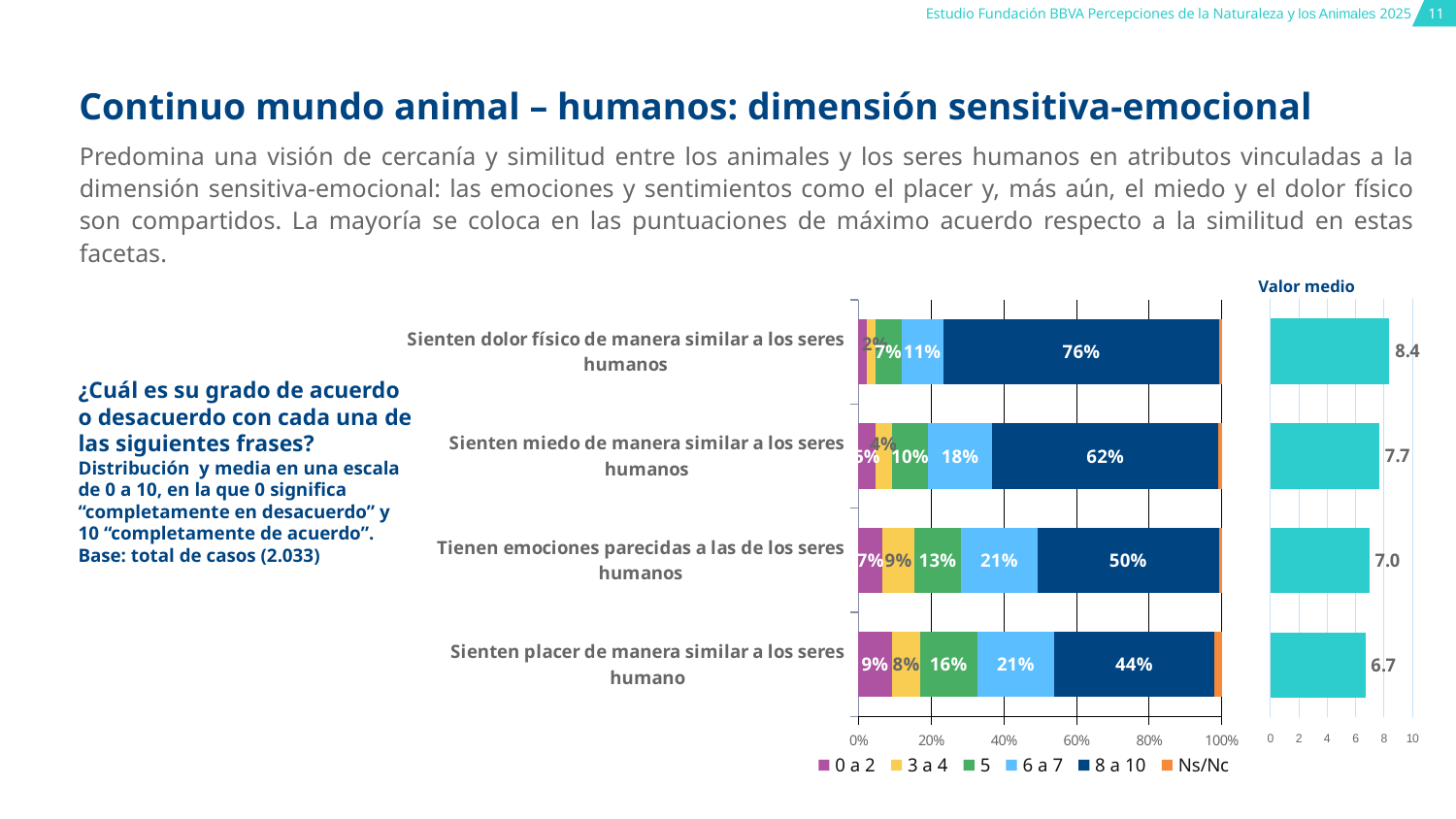
What type of chart is used to show the distribution of scores? Stacked bar chart In the stacked bar chart, what percentage gave a score of 8 a 10 for 'Sienten placer de manera similar a los seres humano'? 44% In the stacked bar chart, what percentage gave a score of 6 a 7 for 'Sienten miedo de manera similar a los seres humanos'? 18% In the 'Valor medio' chart, which statement has the lowest mean value? Sienten placer de manera similar a los seres humano In the 'Valor medio' chart, what is the mean value for 'Tienen emociones parecidas a las de los seres humanos'? 7.0 In the stacked bar chart, which has a larger 8 a 10 share: 'Tienen emociones parecidas' or 'Sienten placer'? Tienen emociones parecidas a las de los seres humanos In the 'Valor medio' chart, what is the difference between the mean values for 'Sienten dolor físico' and 'Sienten placer'? 1.7 How many series does the legend of the stacked bar chart list? 6 In the 'Valor medio' chart, which statement has the highest mean value? Sienten dolor físico de manera similar a los seres humanos How many statements (categories) are shown in the stacked bar chart? 4 In the stacked bar chart, what percentage of respondents gave a score of 8 a 10 for 'Sienten dolor físico de manera similar a los seres humanos'? 76% In the stacked bar chart, what is the difference between the 8 a 10 percentages for 'Sienten dolor físico' and 'Sienten miedo'? 14 percentage points